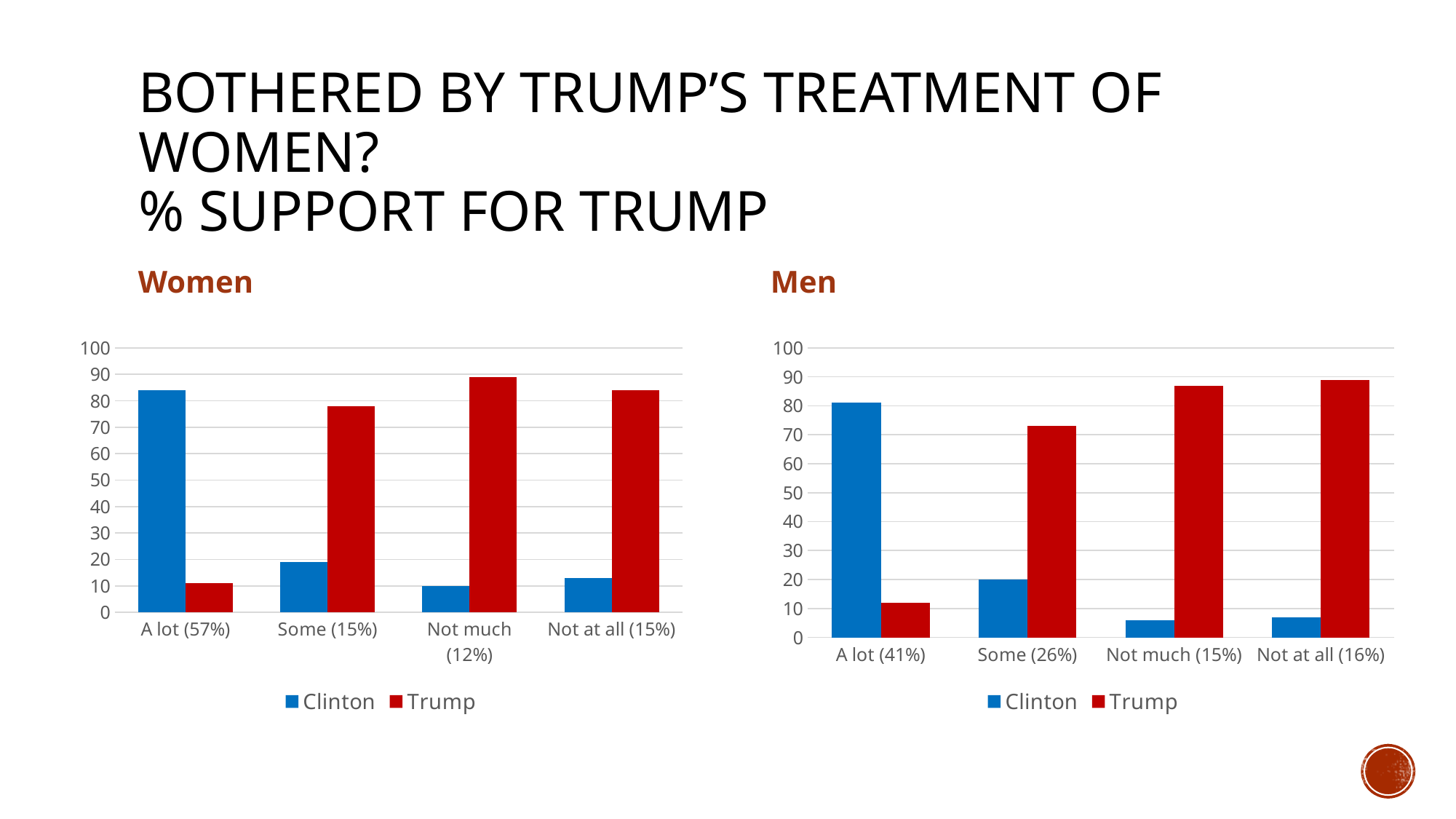
On the Men chart, is the Clinton value for A lot (41%) greater or less than 70? greater On the Women chart, which category has the highest Clinton value? A lot (57%) On the Women chart, which category has the highest Trump value? Not much (12%) On the Men chart, is the Clinton value for Not much (15%) greater or less than 10? less On the Men chart, which category has the lowest Trump value? A lot (41%) On the Women chart, is the Clinton value for A lot (57%) greater or less than 80? greater On the Women chart, how many series does the legend list? 2 On the Women chart, how many categories are shown on the x axis? 4 What kind of chart is the Women chart? Bar chart On the Men chart, which is larger for Some (26%), the Clinton value or the Trump value? Trump On the Men chart, what are the two entries in the legend? Clinton and Trump